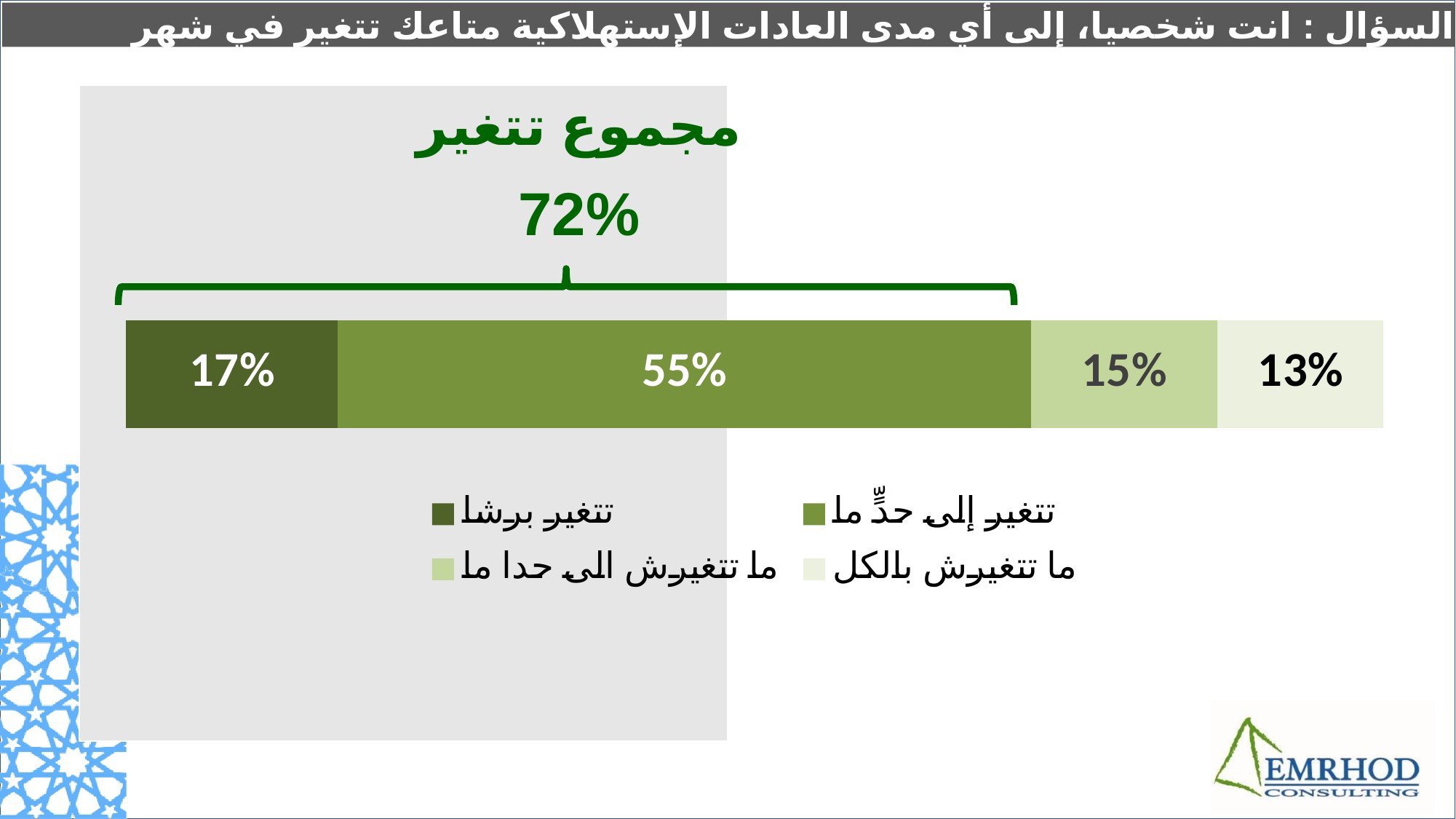
What total is shown above the bracket labelled "مجموع تتغير"? 72% What is the value for "ما تتغيرش بالكل"? 13% Which segment of the bar has the lowest value? ما تتغيرش بالكل Which is larger, the value for "تتغير برشا" or the value for "ما تتغيرش إلى حدا ما"? تتغير برشا What is the difference between the values for "تتغير إلى حدٍّ ما" and "تتغير برشا"? 38% What is the value for "ما تتغيرش إلى حدا ما"? 15% Which legend entry is shown with the darkest green colour? تتغير برشا What is the value for "تتغير إلى حدٍّ ما"? 55% How many series does the legend list? 4 What is the value for "تتغير برشا"? 17% Which segment of the bar has the highest value? تتغير إلى حدٍّ ما What kind of chart is shown on the slide? Stacked bar chart